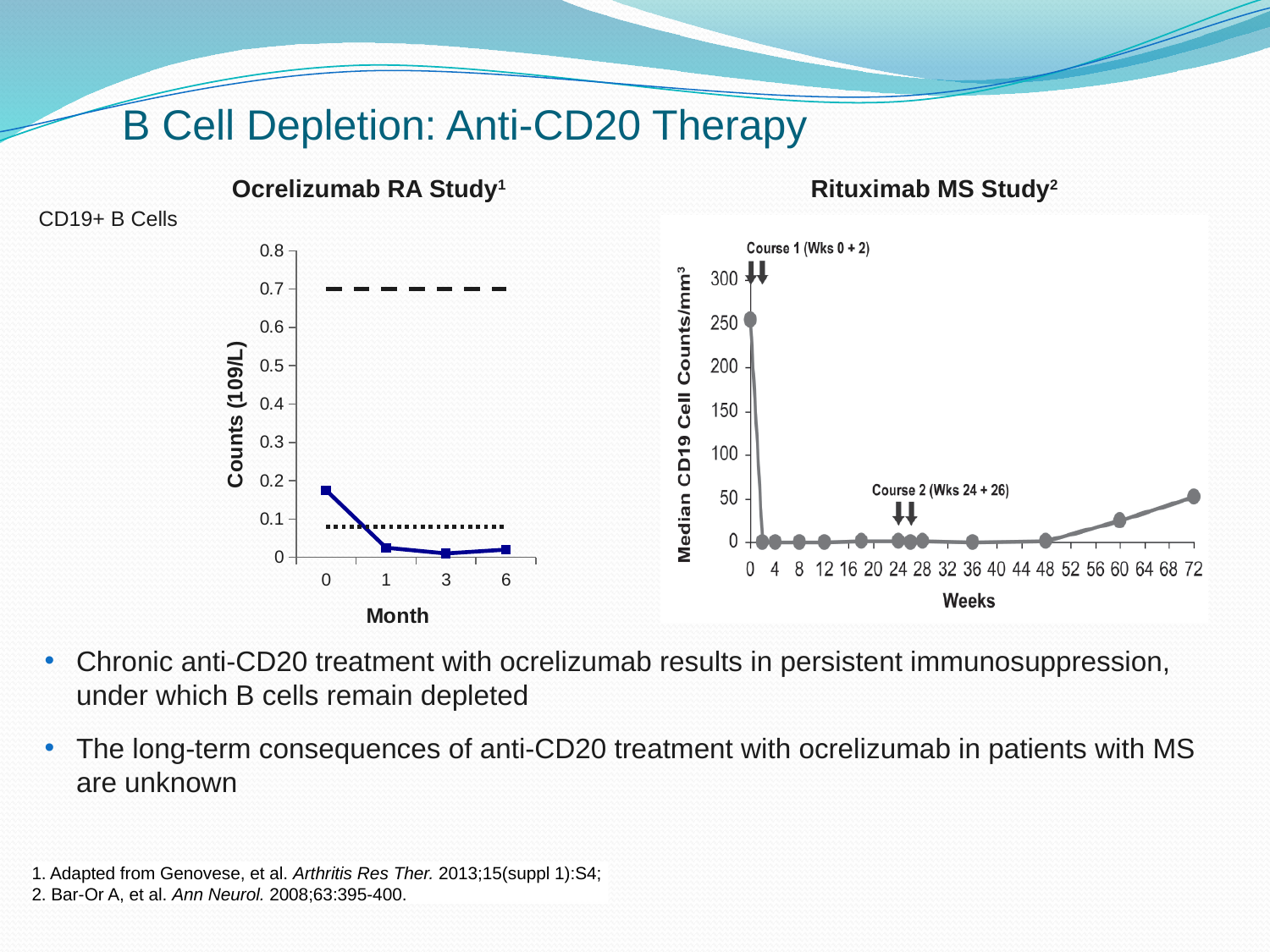
On the Ocrelizumab RA Study chart, which month has the highest count? 0 On the Rituximab MS Study chart, which is larger, the value at week 0 or the value at week 72? week 0 On the Ocrelizumab RA Study chart, is the value at month 1 greater or less than 0.1? less On the Rituximab MS Study chart, is the value at week 0 greater or less than 200? greater What is the x-axis label of the Ocrelizumab RA Study chart? Month How many data points are plotted on the Ocrelizumab RA Study chart? 4 On the Rituximab MS Study chart, is the value at week 72 greater or less than 100? less On the Ocrelizumab RA Study chart, do the counts rise or fall from month 0 to month 1? fall On the Rituximab MS Study chart, which week has the highest median CD19 cell count? 0 What kind of chart is the Ocrelizumab RA Study chart? line chart On the Rituximab MS Study chart, do the values rise or fall from week 48 to week 72? rise